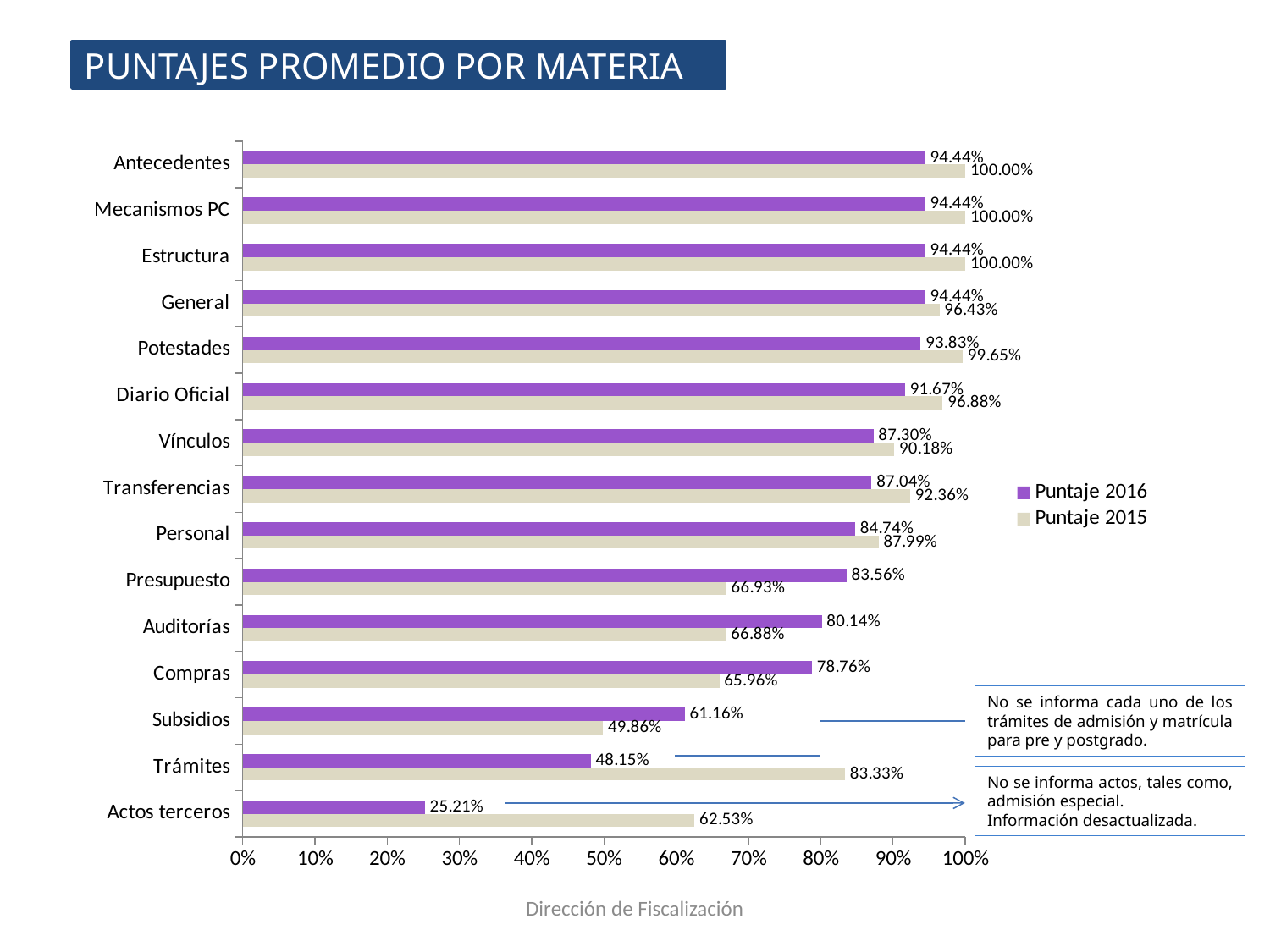
What is the difference between the Puntaje 2015 and Puntaje 2016 values for Trámites? 35.18 percentage points What is the Puntaje 2015 value for Trámites? 83.33% Which category has the lowest Puntaje 2016 value? Actos terceros How many series does the legend list? 2 What is the title of the slide? PUNTAJES PROMEDIO POR MATERIA What kind of chart is shown on the slide? Bar chart What is the Puntaje 2016 value for Compras? 78.76% How many categories are shown on the chart? 15 Which category has the lowest Puntaje 2015 value? Subsidios What is the Puntaje 2016 value for Actos terceros? 25.21% What is the Puntaje 2015 value for Potestades? 99.65% For Presupuesto, which is larger: Puntaje 2016 or Puntaje 2015? Puntaje 2016